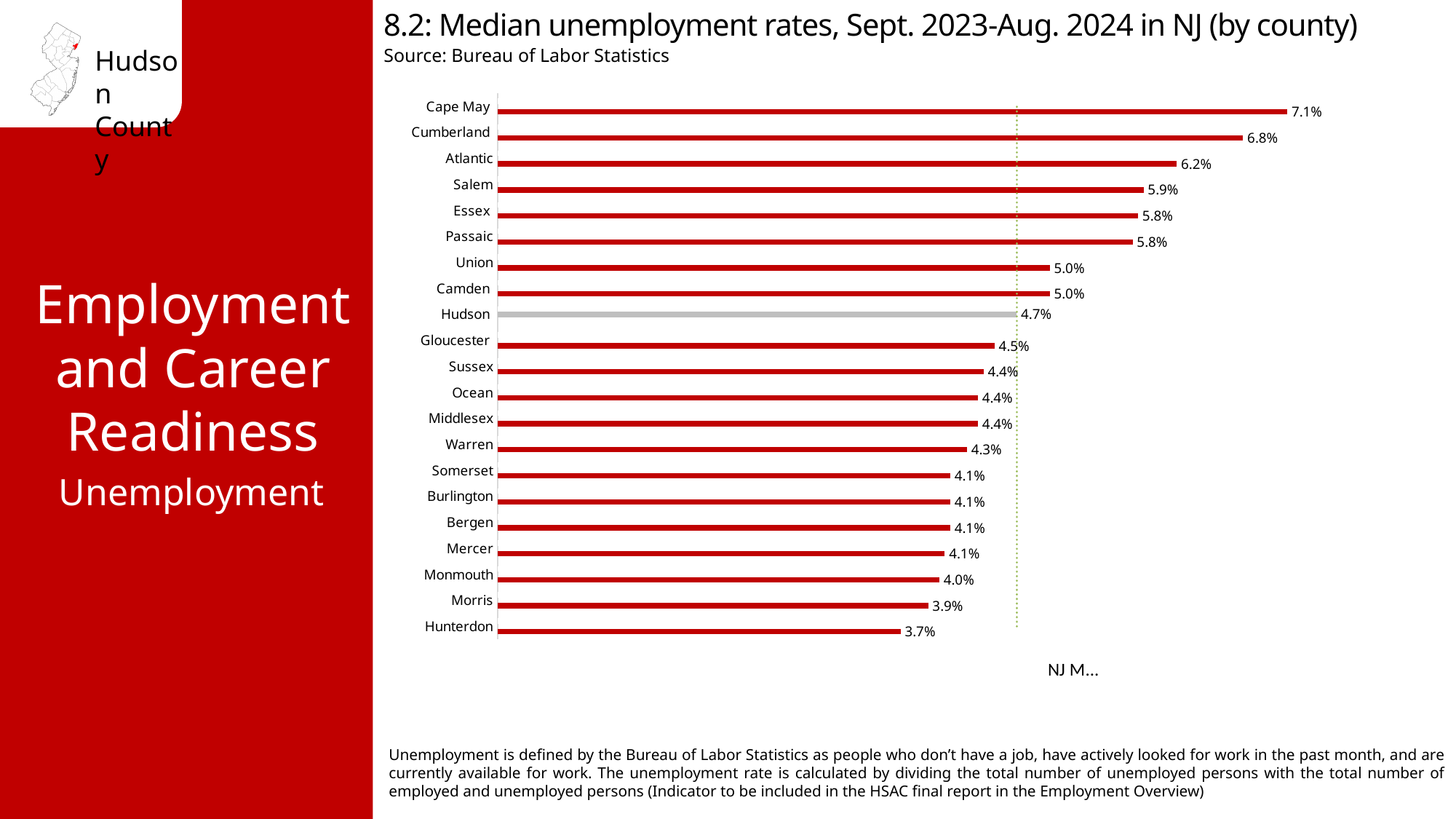
What is the median unemployment rate for Cape May? 7.1% What is the median unemployment rate for Atlantic? 6.2% What is the difference between the median unemployment rates of Cape May and Hunterdon? 3.4% What is the median unemployment rate for Hunterdon? 3.7% What kind of chart is shown on the slide? Bar chart How many counties are shown in the chart? 21 Which county has the highest median unemployment rate? Cape May Which has a higher median unemployment rate, Salem or Union? Salem What is the difference between the median unemployment rates of Cumberland and Hudson? 2.1% Which county's bar is coloured grey instead of red? Hudson What is the median unemployment rate for Hudson County? 4.7% Which county has the lowest median unemployment rate? Hunterdon